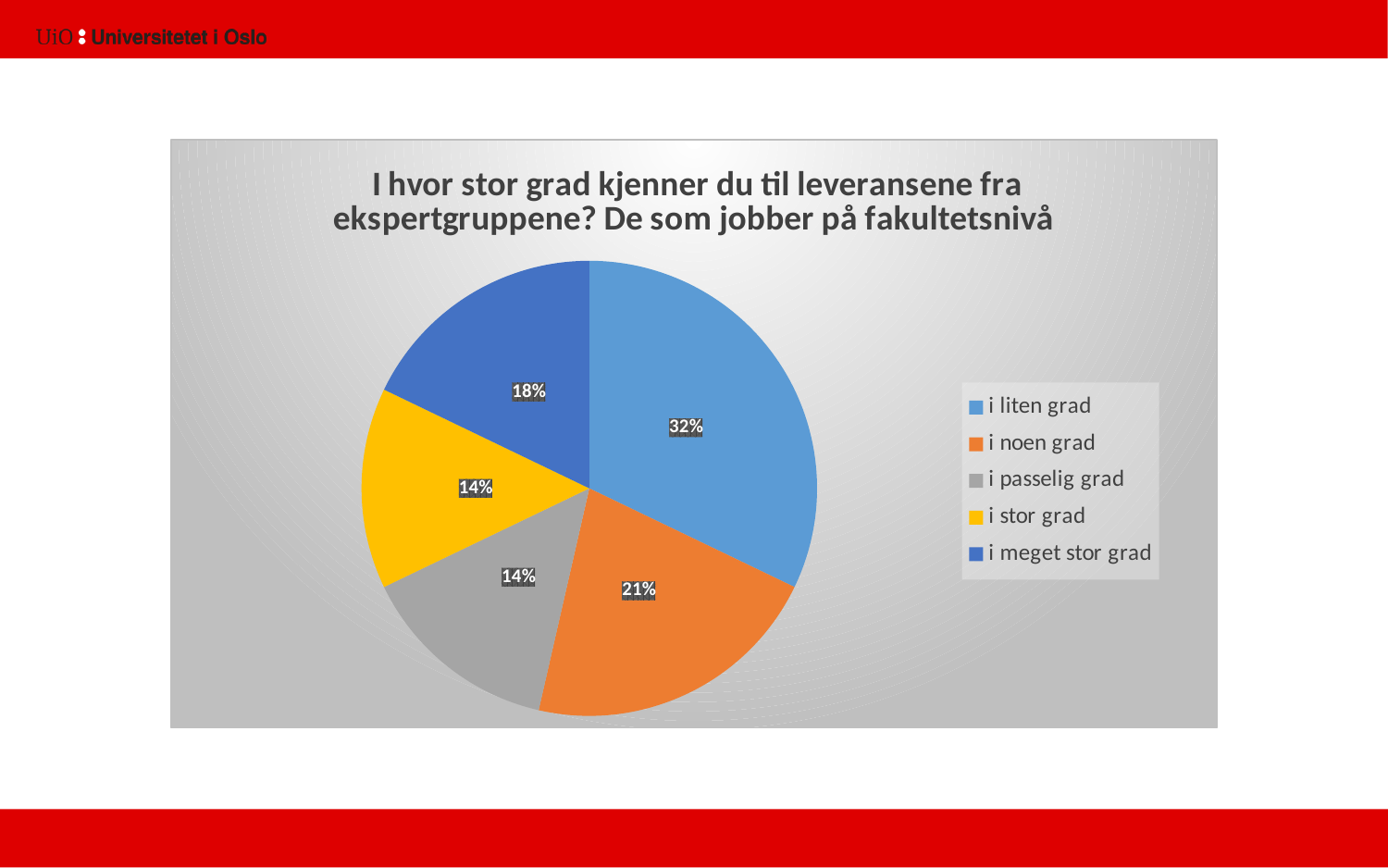
What share of the pie is labelled 'i liten grad'? 32% What share of the pie is labelled 'i noen grad'? 21% Which category has the largest slice of the pie? i liten grad What is the difference in percentage points between 'i meget stor grad' and 'i stor grad'? 4 What share of the pie is labelled 'i meget stor grad'? 18% How many entries does the legend list? 5 How many slices does the pie chart have? 5 What colour is the slice for 'i stor grad'? yellow What is the difference in percentage points between 'i liten grad' and 'i noen grad'? 11 Which is larger, the slice for 'i noen grad' or the slice for 'i meget stor grad'? i noen grad What kind of chart is shown on the slide? pie chart